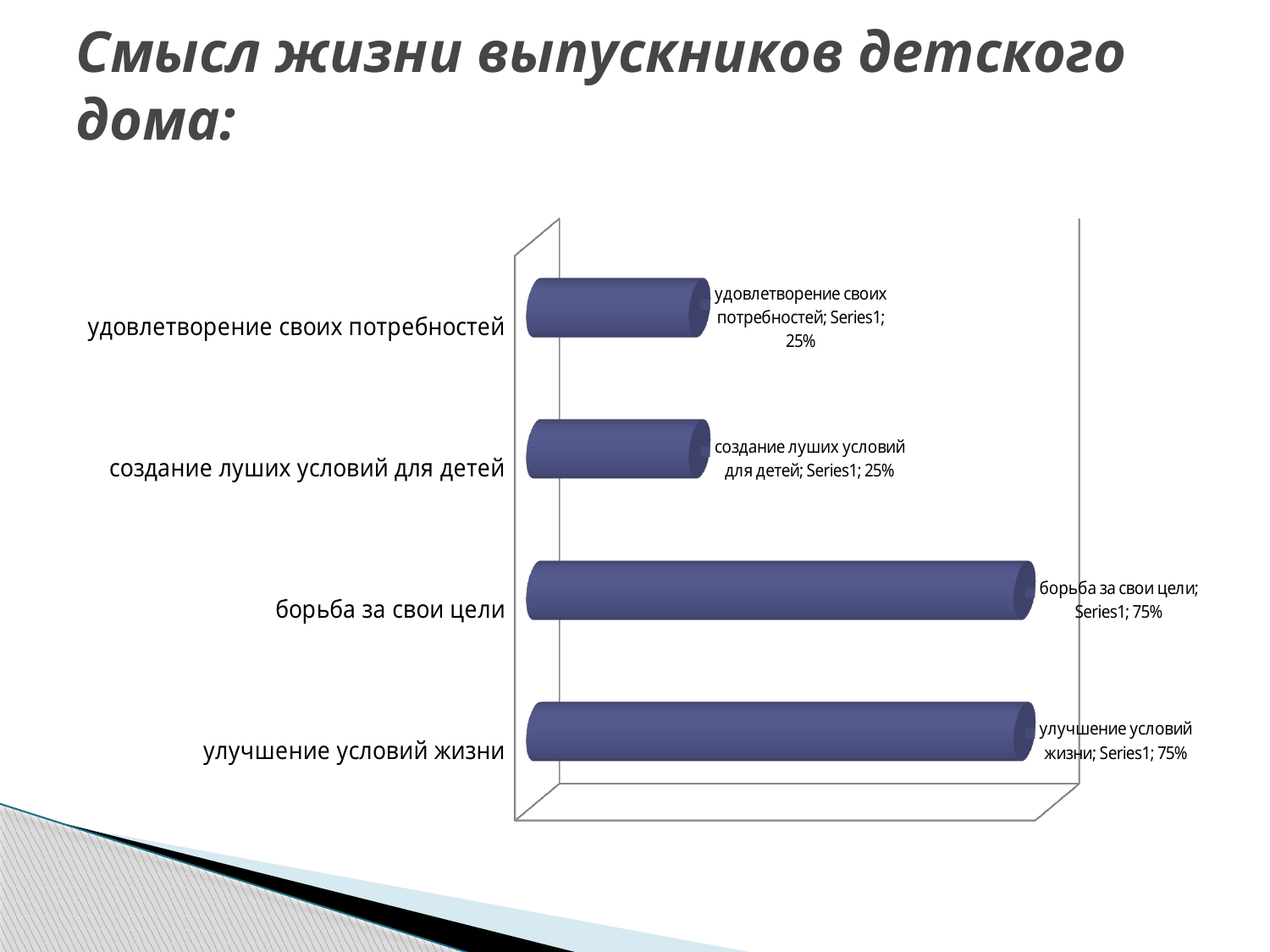
What is the difference between the value for «улучшение условий жизни» and the value for «удовлетворение своих потребностей»? 50% What is the title of the slide? Смысл жизни выпускников детского дома: What is the value for «создание луших условий для детей»? 25% What is the value for «борьба за свои цели»? 75% What kind of chart is shown on the slide? bar chart What is the value for «удовлетворение своих потребностей»? 25% What is the value for «улучшение условий жизни»? 75% What series name appears in the data labels of the chart? Series1 Which is larger, the value for «удовлетворение своих потребностей» or the value for «улучшение условий жизни»? улучшение условий жизни What is the difference between the value for «борьба за свои цели» and the value for «создание луших условий для детей»? 50% How many categories are shown in the chart? 4 Which is larger, the value for «борьба за свои цели» or the value for «создание луших условий для детей»? борьба за свои цели